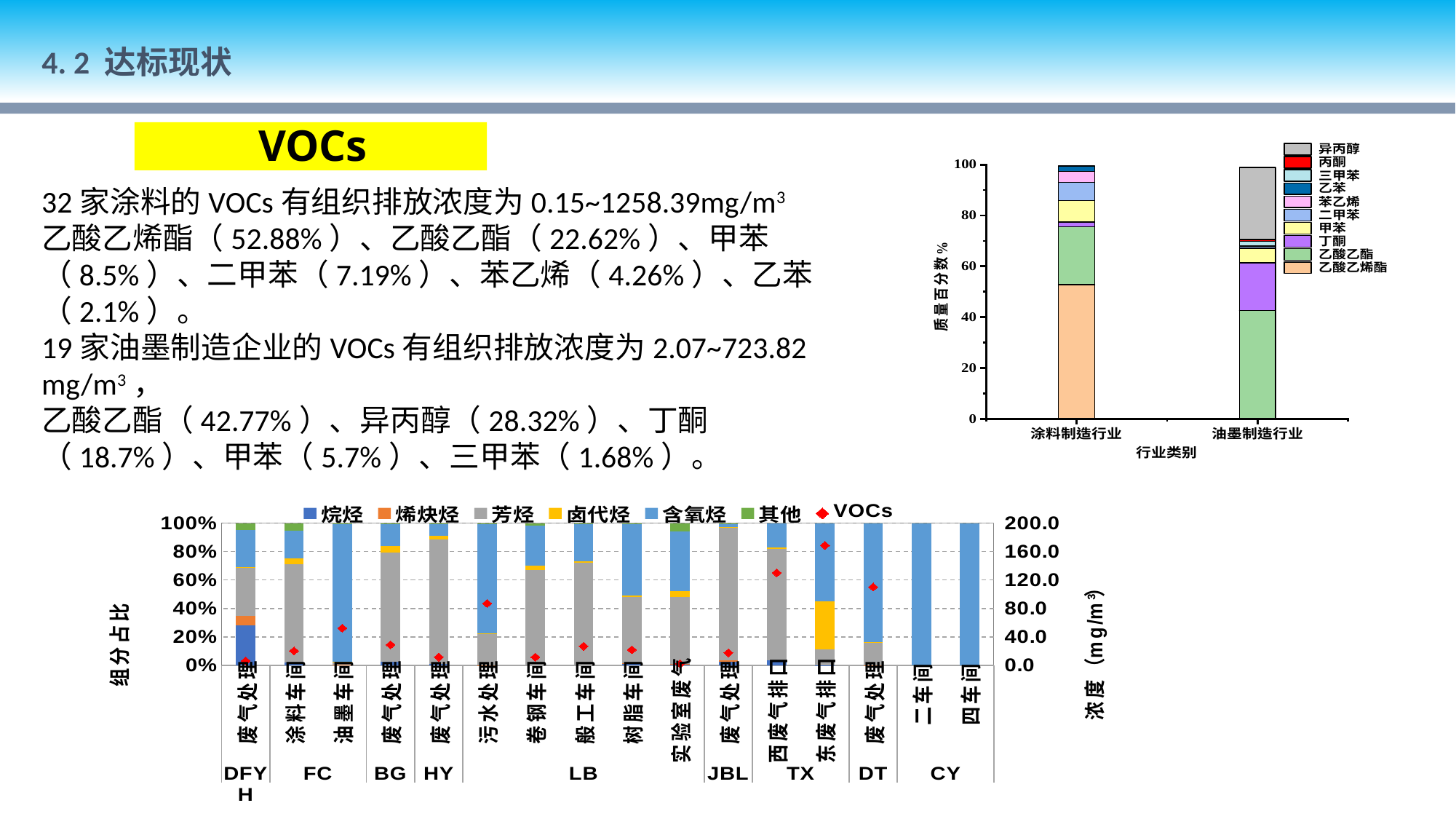
In the bottom chart, how many series does the legend list? 7 In the top-right chart, what is the label of the y axis? 质量百分数% In the top-right chart, which category has the larger 乙酸乙烯酯 segment, 涂料制造行业 or 油墨制造行业? 涂料制造行业 In the top-right chart, how many series does the legend list? 10 In the bottom chart, how many bars (sampling points) are shown along the x axis? 16 In the top-right chart, is the 乙酸乙酯 share for 油墨制造行业 greater or less than 20? greater In the top-right chart, is the 乙酸乙烯酯 share for 涂料制造行业 greater or less than 40? greater What kind of chart is the top-right chart? stacked bar chart In the bottom chart, what is the maximum value shown on the right-hand 浓度 axis? 200.0 In the bottom chart, is the VOCs concentration for 东废气排口 greater or less than 120.0? greater In the top-right chart, how many categories are shown on the x axis (行业类别)? 2